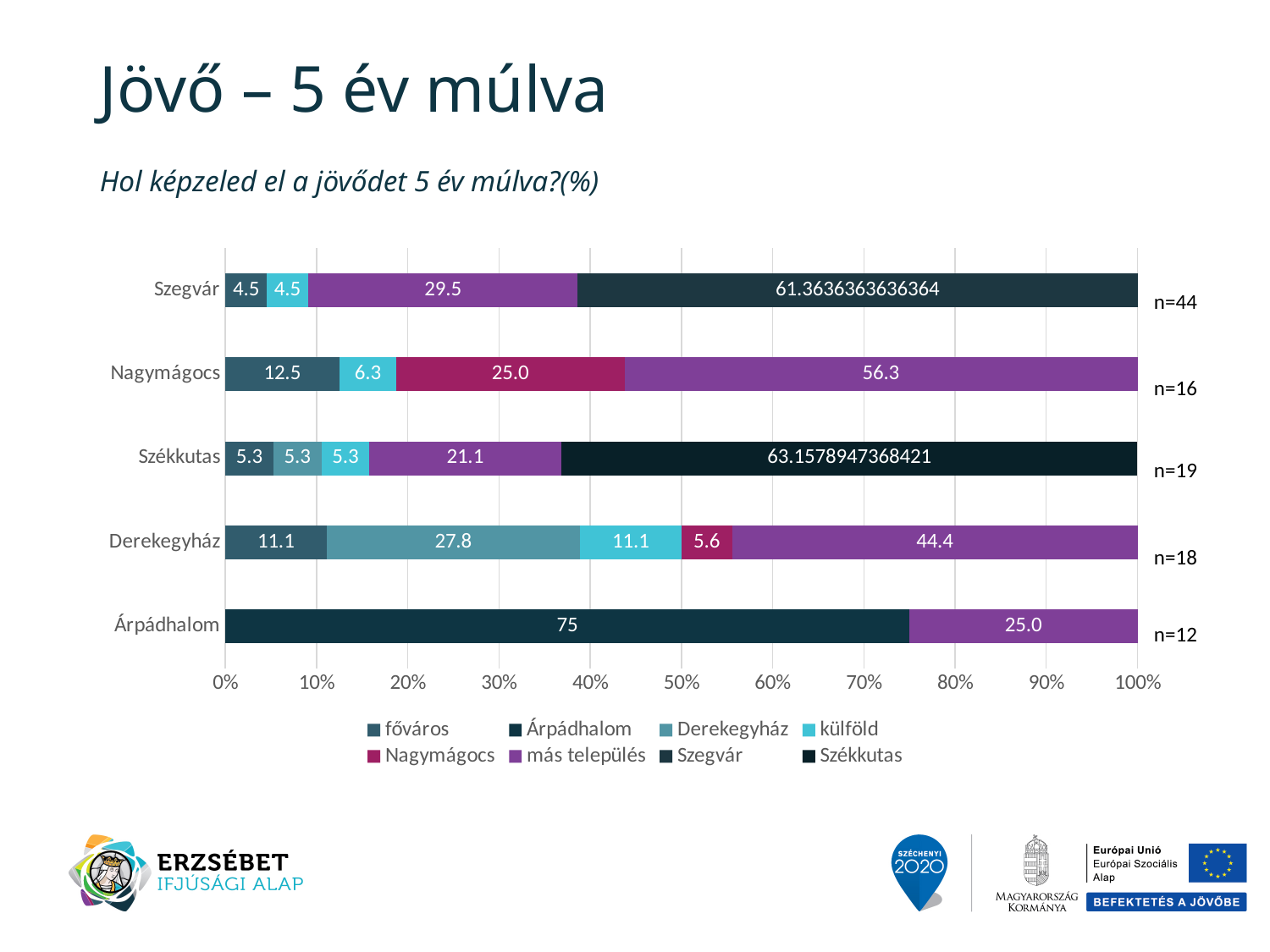
How many series does the chart's legend list? 8 What kind of chart is shown on the slide? bar chart What is the value of the largest segment in the Árpádhalom bar? 75 Which is larger, the 'más település' value for Szegvár or for Székkutas? Szegvár Which settlement has the highest 'más település' value? Nagymágocs How many categories (settlements) are plotted on the vertical axis of the chart? 5 What sample size (n) is shown next to the Szegvár bar? n=44 What is the value of the 'más település' segment for Derekegyház? 44.4 What is the value of the 'külföld' segment for Nagymágocs? 6.3 What is the value of the 'más település' segment for Nagymágocs? 56.3 What is the value of the 'Nagymágocs' segment in the Derekegyház bar? 5.6 What is the difference between the 'más település' values for Nagymágocs and Derekegyház? 11.9